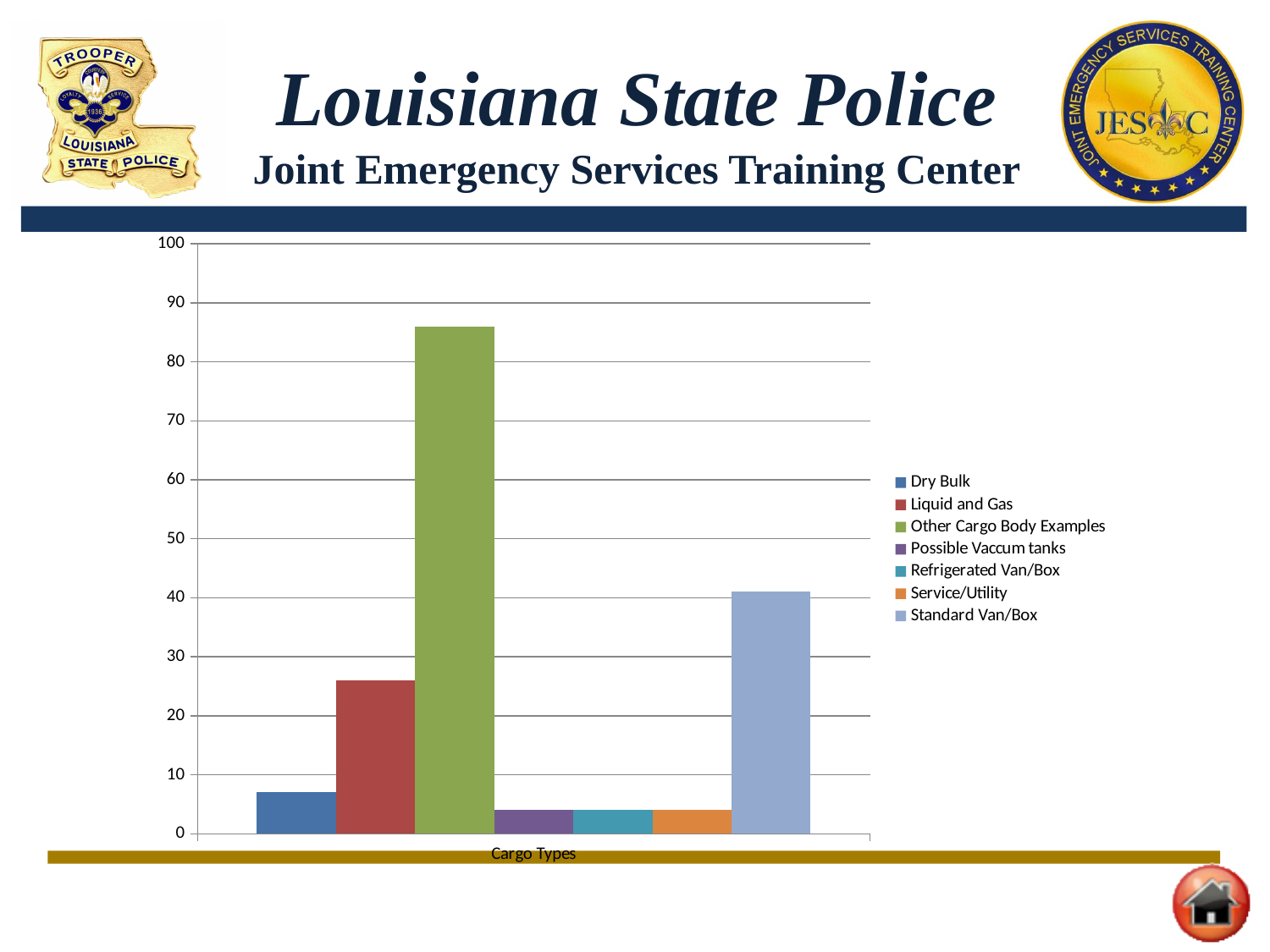
Is the value for Standard Van/Box greater or less than 50? less Which is larger, the value for Standard Van/Box or the value for Liquid and Gas? Standard Van/Box How many series does the legend list? 7 What is the label on the horizontal axis of the chart? Cargo Types Is the value for Other Cargo Body Examples greater or less than 80? greater Is the value for Dry Bulk greater or less than 10? less Which is larger, the value for Dry Bulk or the value for Service/Utility? Dry Bulk What kind of chart is shown on the slide? bar chart Which series has the highest bar? Other Cargo Body Examples